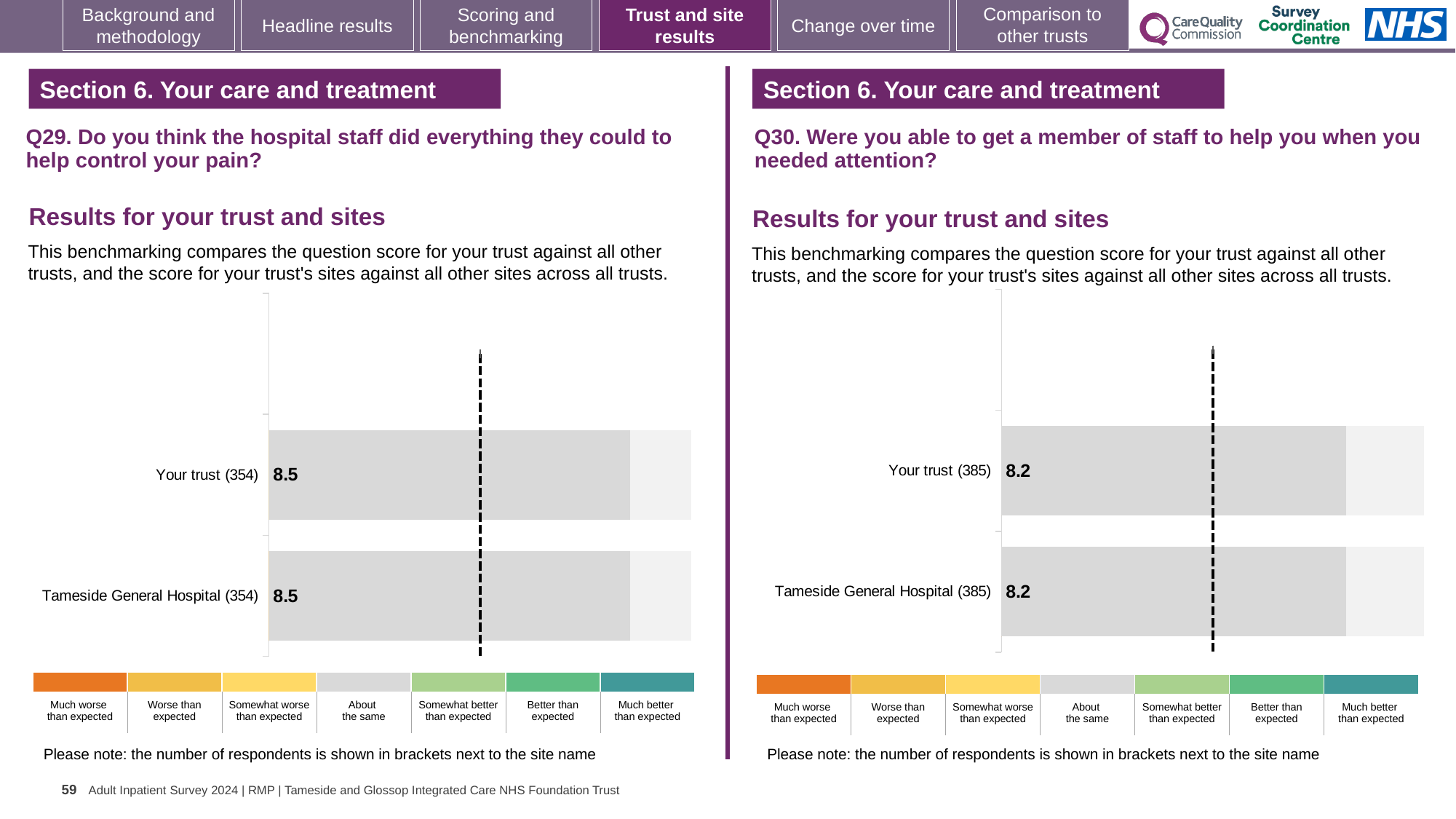
How many bars are plotted in the Q30 chart on the right? 2 Is the score for Your trust in the Q29 chart on the left greater or less than the score for Your trust in the Q30 chart on the right? greater What kind of chart is used for the Q30 results on the right? Bar chart In the Q29 chart on the left, what is the score for Your trust? 8.5 In the Q29 chart on the left, what is the difference between the score for Your trust and the score for Tameside General Hospital? 0 In the Q29 chart on the left, what is the score for Tameside General Hospital? 8.5 In the Q30 chart on the right, what is the score for Your trust? 8.2 How many bars are plotted in the Q29 chart on the left? 2 In the Q30 chart on the right, what is the score for Tameside General Hospital? 8.2 In the Q30 chart on the right, how many respondents are shown in brackets next to Tameside General Hospital? 385 In the Q30 chart on the right, what is the difference between the score for Your trust and the score for Tameside General Hospital? 0 In the Q29 chart on the left, how many respondents are shown in brackets next to Your trust? 354